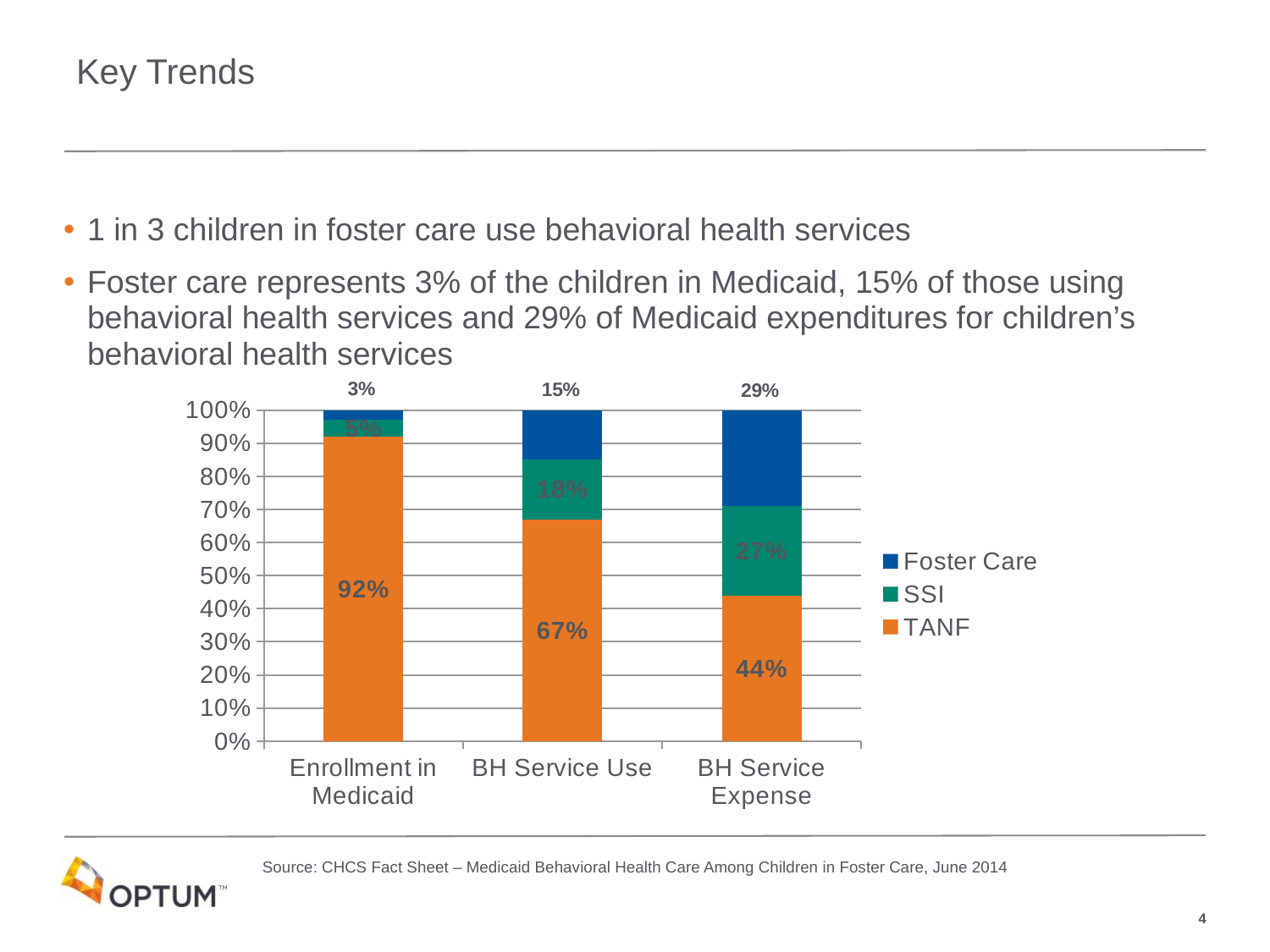
Do the Foster Care values rise or fall from Enrollment in Medicaid to BH Service Expense? Rise How many series does the chart legend list? 3 How many categories are shown on the x axis of the chart? 3 What is the SSI value for BH Service Use? 18% What is the TANF value for BH Service Expense? 44% What is the difference between the TANF values for Enrollment in Medicaid and BH Service Use? 25% Is the SSI value for BH Service Expense larger than the Foster Care value for BH Service Use? Yes What is the TANF value for Enrollment in Medicaid? 92% What is the Foster Care value for BH Service Expense? 29% Which category has the lowest TANF value? BH Service Expense What kind of chart is shown on the slide? Stacked bar chart Which category has the highest Foster Care value? BH Service Expense